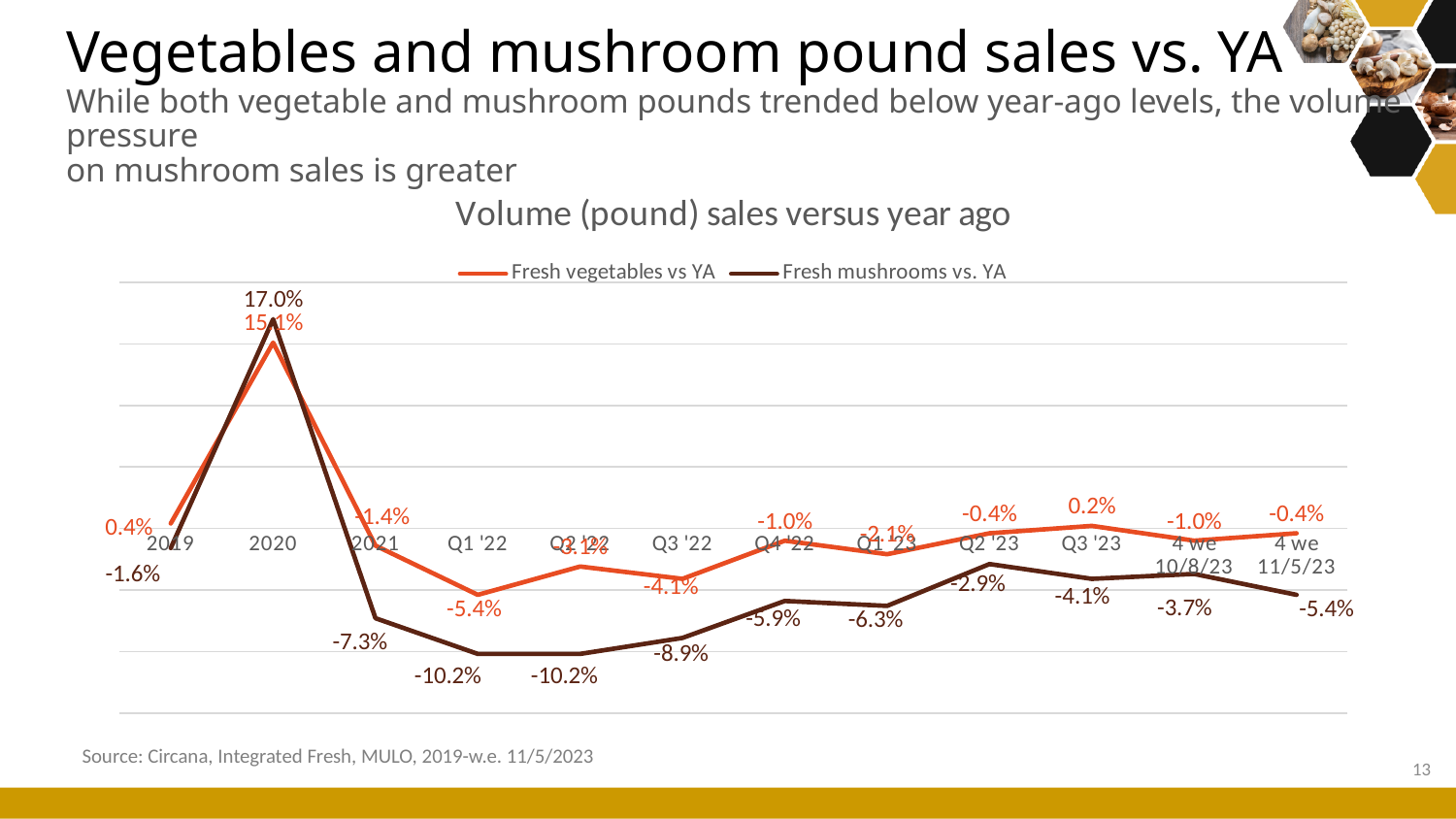
What kind of chart is shown on the slide? Line chart What is the value for Fresh vegetables vs YA in 2020? 15.1% How many series does the legend list? 2 What is the value for Fresh mushrooms vs. YA in 2020? 17.0% By how many percentage points does Fresh mushrooms vs. YA exceed Fresh vegetables vs YA in 2020? 1.9 percentage points For the 4 weeks ending 11/5/23, which series has the higher value, Fresh vegetables vs YA or Fresh mushrooms vs. YA? Fresh vegetables vs YA What is the value for Fresh mushrooms vs. YA for the 4 weeks ending 11/5/23? -5.4% In which period is Fresh vegetables vs YA highest? 2020 In which period is Fresh vegetables vs YA lowest? Q1 '22 What is the value for Fresh mushrooms vs. YA in Q1 '22? -10.2% How many time periods are plotted along the x axis? 12 What is the value for Fresh vegetables vs YA in Q3 '23? 0.2%